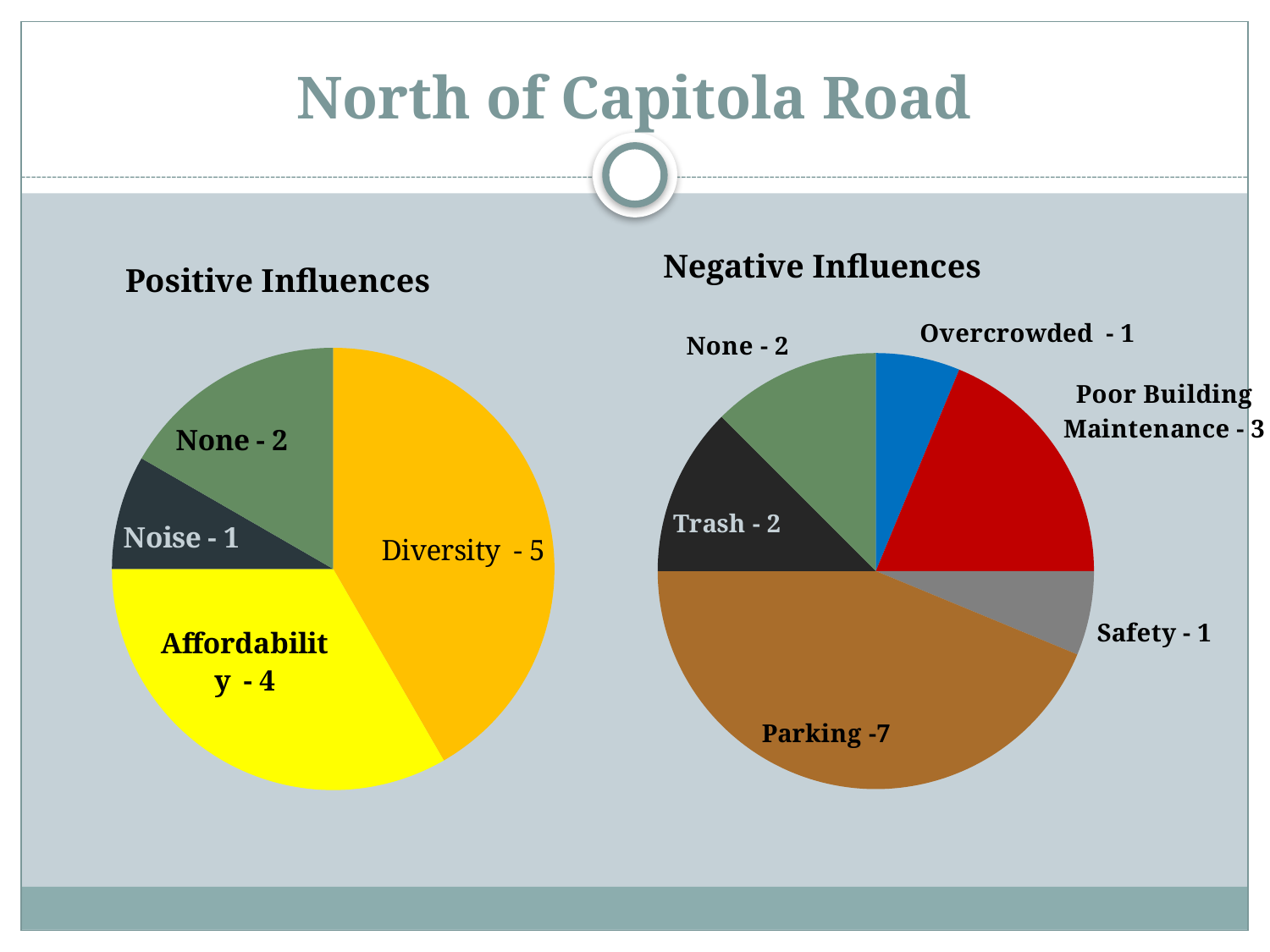
In the Positive Influences chart, which category has the largest slice? Diversity In the Positive Influences chart, which is larger, Affordability or None? Affordability What is the title of the slide? North of Capitola Road In the Positive Influences chart, what is the value for Diversity? 5 What type of chart is the Positive Influences chart? Pie chart In the Negative Influences chart, what is the difference between the values for Parking and Trash? 5 In the Negative Influences chart, what is the total of all the slice values? 16 In the Negative Influences chart, what is the value for Poor Building Maintenance? 3 In the Positive Influences chart, which category has the smallest slice? Noise How many categories are shown in the Positive Influences chart? 4 In the Negative Influences chart, which category has the largest slice? Parking How many categories are shown in the Negative Influences chart? 6